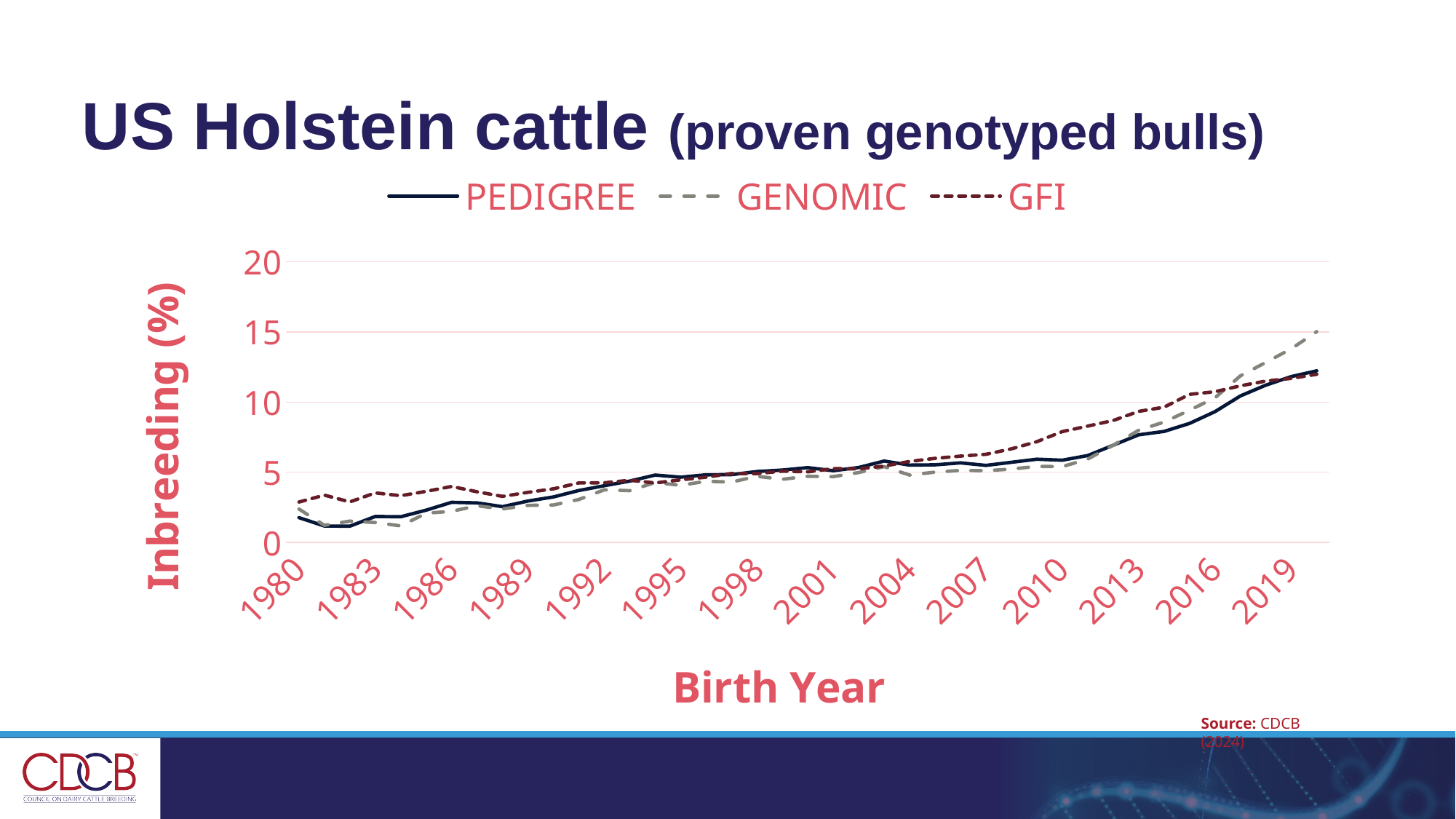
Do the inbreeding values generally rise or fall from 1980 to 2019? rise How many year labels are shown on the x axis? 14 Is the GENOMIC value for 2019 greater or less than 10? greater Is the GENOMIC value for 2010 greater or less than 10? less At 2010, which series has the higher value, GFI or GENOMIC? GFI Is the GFI value for 2010 greater or less than 5? greater Which series are listed in the legend? PEDIGREE, GENOMIC, GFI How many series does the legend list? 3 What kind of chart is shown on the slide? line chart At 1980, which series has the higher value, GFI or PEDIGREE? GFI What is the label of the y axis? Inbreeding (%)